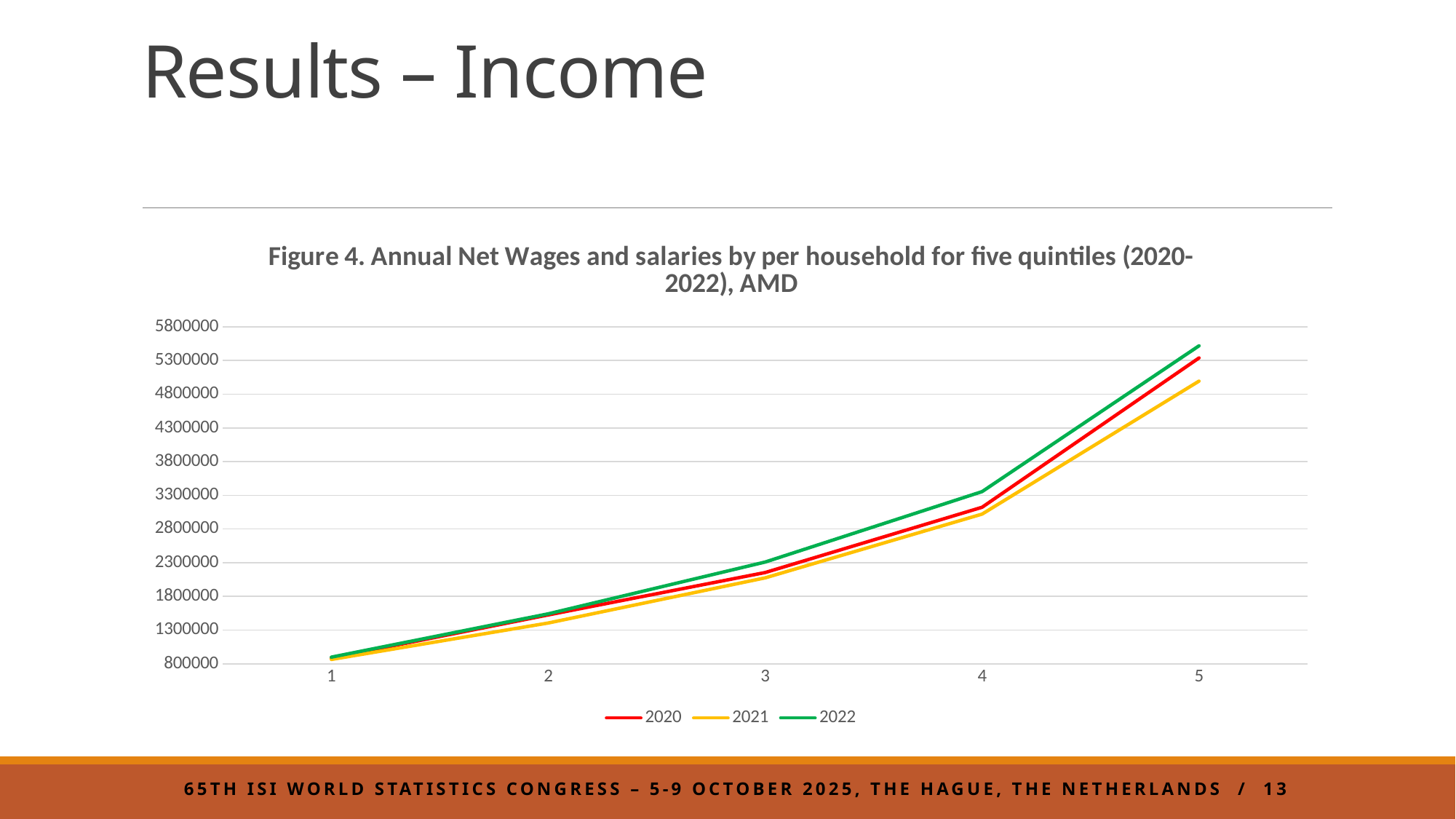
How many series does the legend list? 3 Is the value for 2020 at quintile 3 greater or less than 2300000? less At quintile 5, which is larger: the value for 2022 or the value for 2021? 2022 Which series has the lowest value at quintile 5? 2021 Do the values for 2022 rise or fall from quintile 1 to quintile 5? rise How many quintiles are plotted along the x axis? 5 Is the value for 2021 at quintile 4 greater or less than 2800000? greater Is the value for 2021 at quintile 5 greater or less than 4800000? greater What colour is the line for the 2022 series? green What kind of chart is shown on the slide? line chart Which series has the highest value at quintile 5? 2022